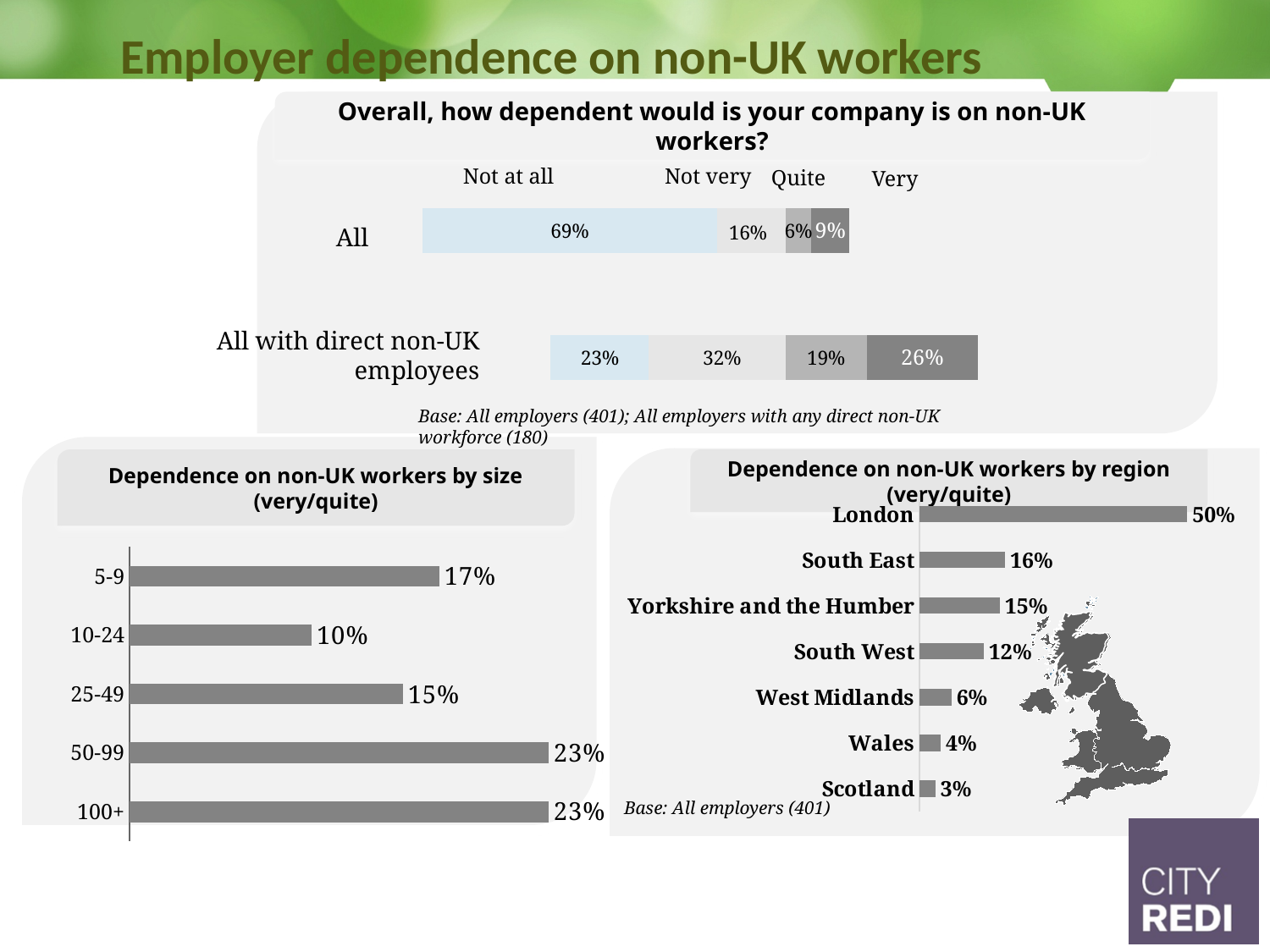
In the chart 'Dependence on non-UK workers by size (very/quite)', what is the value for the 10-24 size band? 10% In the chart 'Dependence on non-UK workers by region (very/quite)', what is the value for the West Midlands? 6% In the chart 'Dependence on non-UK workers by region (very/quite)', which is larger, the value for South East or the value for South West? South East In the chart 'Dependence on non-UK workers by region (very/quite)', which region has the highest value? London In the chart 'Dependence on non-UK workers by size (very/quite)', what is the difference between the 50-99 band and the 25-49 band? 8% In the top chart 'Overall, how dependent would is your company is on non-UK workers?', what percentage of employers with direct non-UK employees answered 'Very'? 26% In the chart 'Dependence on non-UK workers by size (very/quite)', how many size bands are shown? 5 In the top chart 'Overall, how dependent would is your company is on non-UK workers?', what is the combined 'Quite' and 'Very' share for 'All with direct non-UK employees'? 45% In the top chart 'Overall, how dependent would is your company is on non-UK workers?', how many response categories does the legend list? 4 In the top chart 'Overall, how dependent would is your company is on non-UK workers?', what percentage of all employers answered 'Not at all'? 69% In the top chart 'Overall, how dependent would is your company is on non-UK workers?', what is the difference between the 'Not very' share for 'All with direct non-UK employees' and for 'All'? 16% In the chart 'Dependence on non-UK workers by size (very/quite)', which size band has the lowest value? 10-24